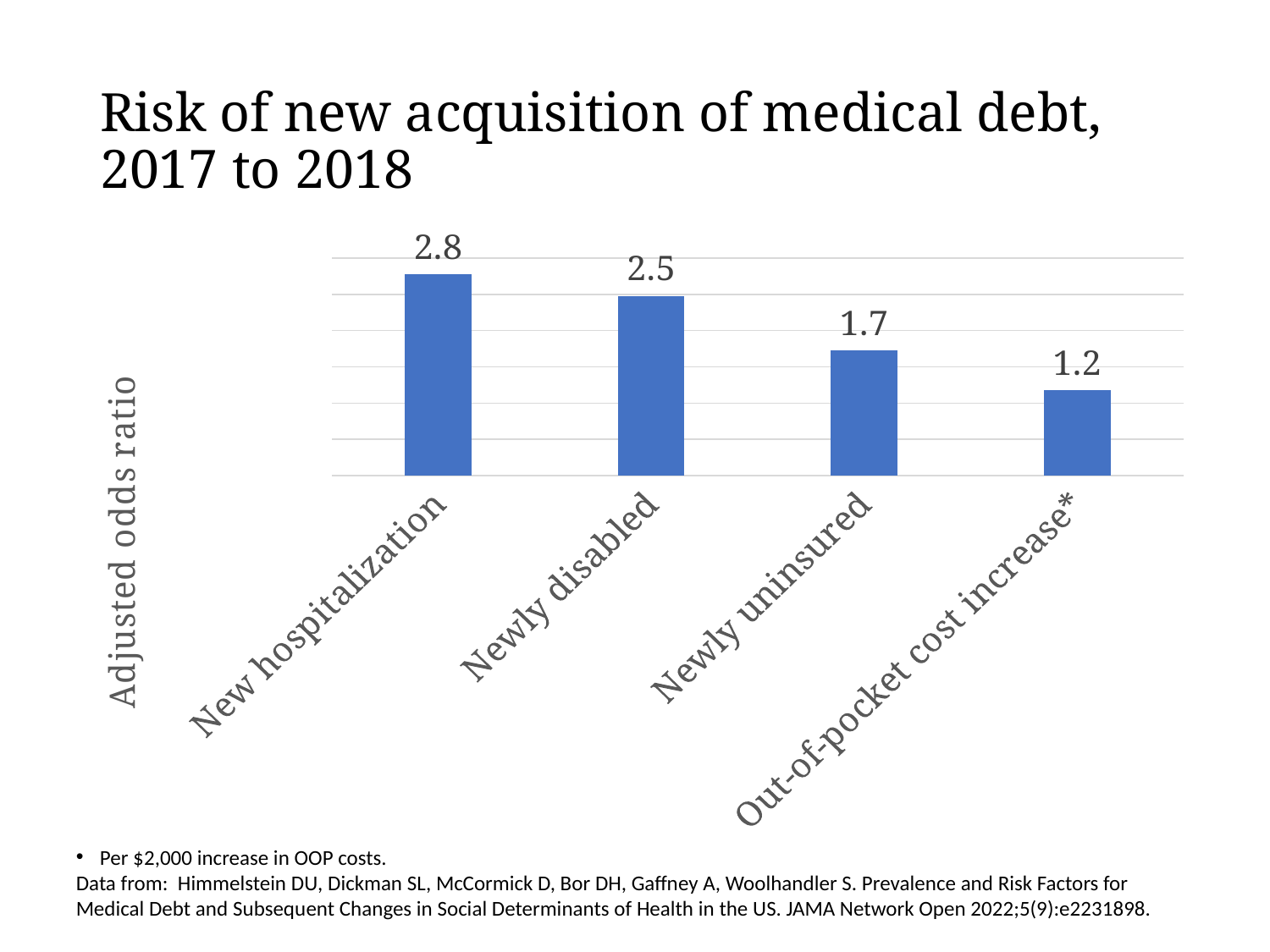
Which has a larger adjusted odds ratio, Newly disabled or Newly uninsured? Newly disabled Which category has the highest adjusted odds ratio? New hospitalization What is the adjusted odds ratio for New hospitalization? 2.8 What kind of chart is shown on the slide? Bar chart What is the difference between the adjusted odds ratios for New hospitalization and Newly uninsured? 1.1 What is the adjusted odds ratio for Newly uninsured? 1.7 Which category has the lowest adjusted odds ratio? Out-of-pocket cost increase* What is the difference between the adjusted odds ratios for Newly disabled and Out-of-pocket cost increase*? 1.3 Do the values rise or fall from left to right across the categories? Fall What is the adjusted odds ratio for Out-of-pocket cost increase*? 1.2 How many categories are shown in the chart? 4 What is the adjusted odds ratio for Newly disabled? 2.5